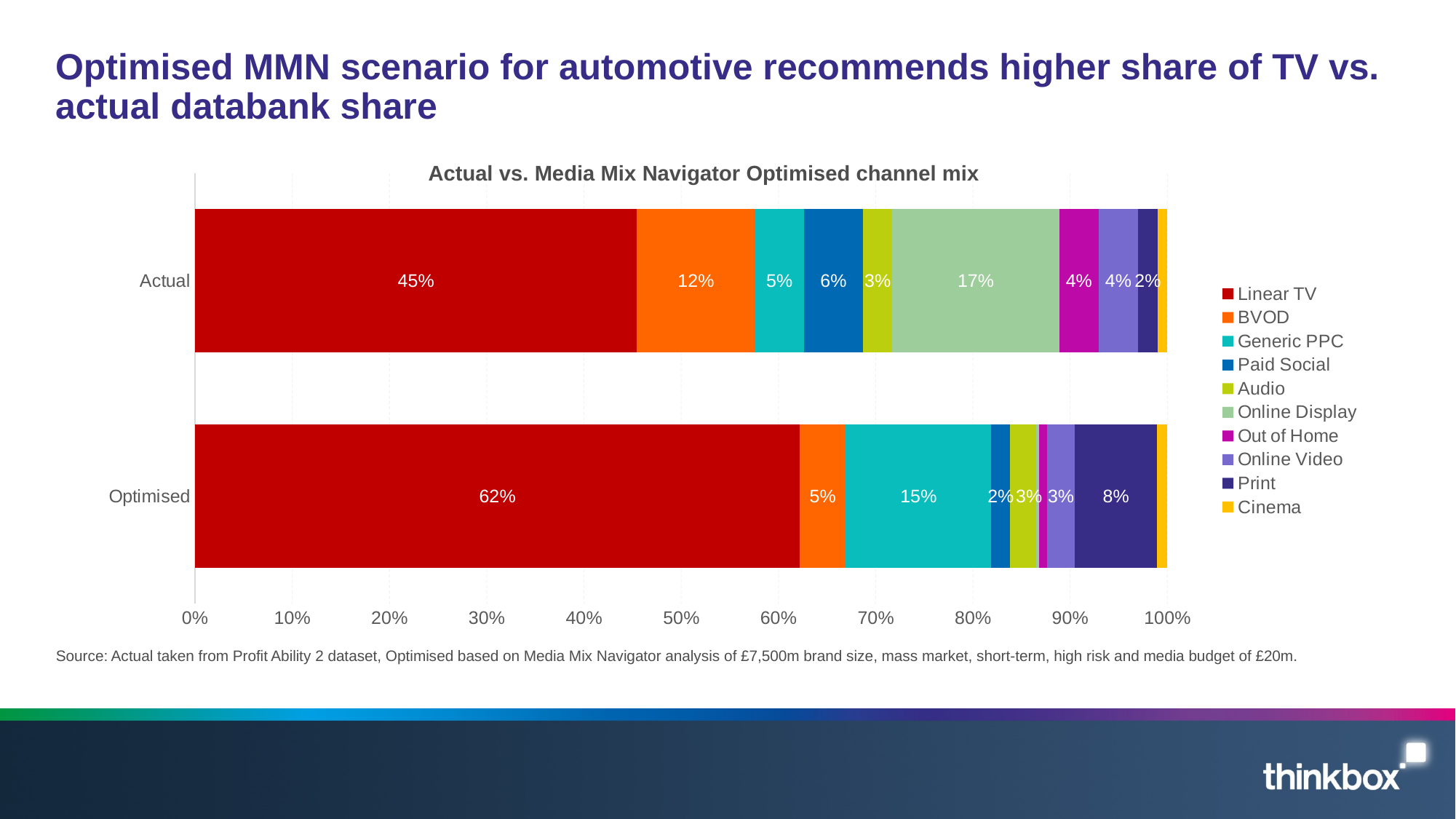
How many series does the legend list? 10 What is the Linear TV share in the Optimised bar? 62% How many bars (categories) are shown on the chart? 2 What is the Print share in the Optimised bar? 8% By how many percentage points is the Linear TV share higher in the Optimised bar than in the Actual bar? 17 percentage points What is the Linear TV share in the Actual bar? 45% Which channel has the largest share in the Actual bar? Linear TV Which bar has the larger BVOD share, Actual or Optimised? Actual What type of chart is shown on the slide? Stacked bar chart What is the Generic PPC share in the Optimised bar? 15% What is the Online Display share in the Actual bar? 17% What is the Paid Social share in the Actual bar? 6%